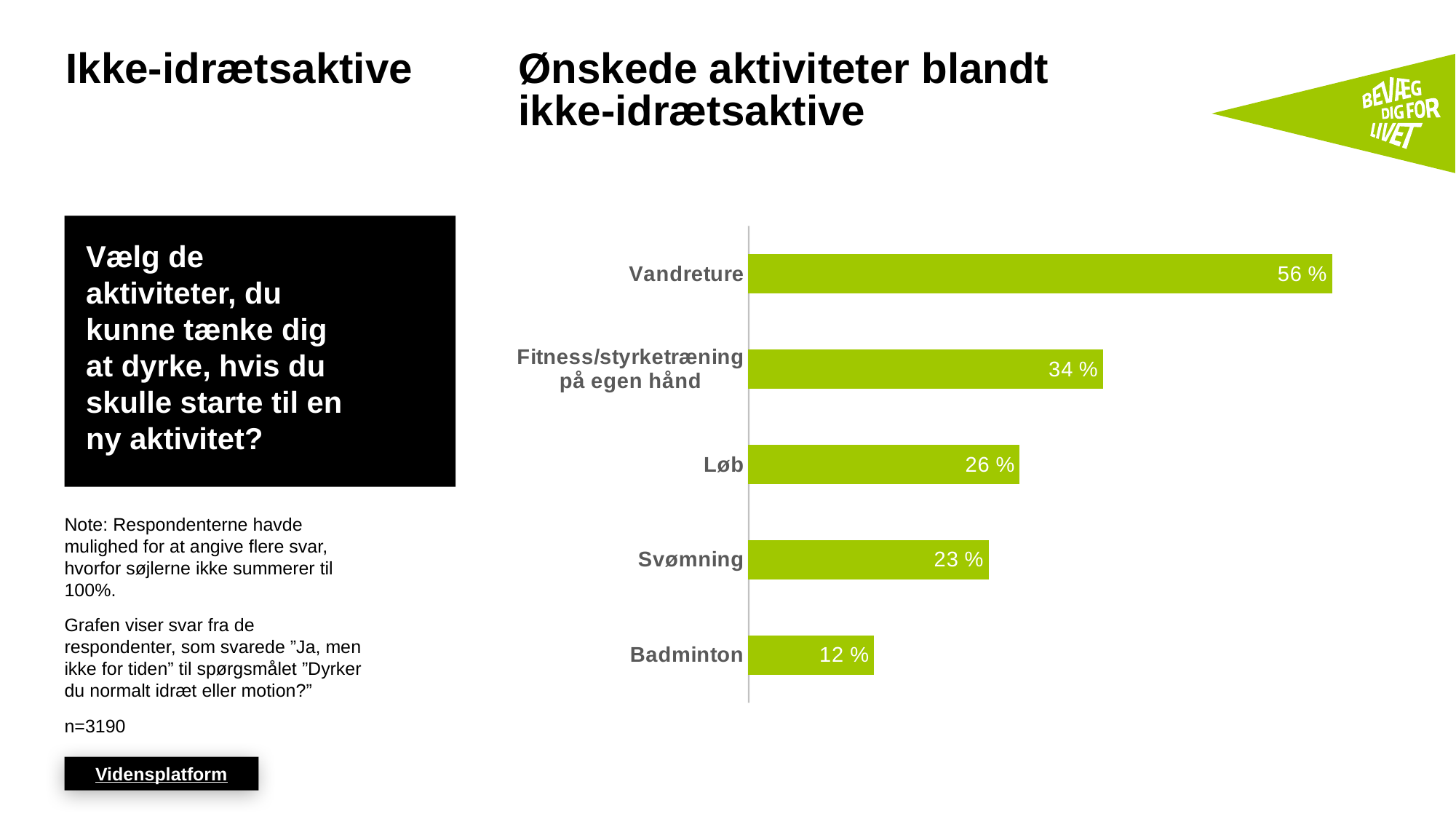
What kind of chart is shown on the slide? Bar chart What is the value for Svømning? 23 % Which is larger, the value for Fitness/styrketræning på egen hånd or the value for Løb? Fitness/styrketræning på egen hånd What is the value for Fitness/styrketræning på egen hånd? 34 % What is the value for Badminton? 12 % What is the difference between the values for Løb and Svømning? 3 % How many activities are shown in the chart? 5 Which activity has the lowest value? Badminton Which activity has the highest value? Vandreture What is the difference between the values for Vandreture and Badminton? 44 % What is the value for Løb? 26 % What is the value for Vandreture? 56 %